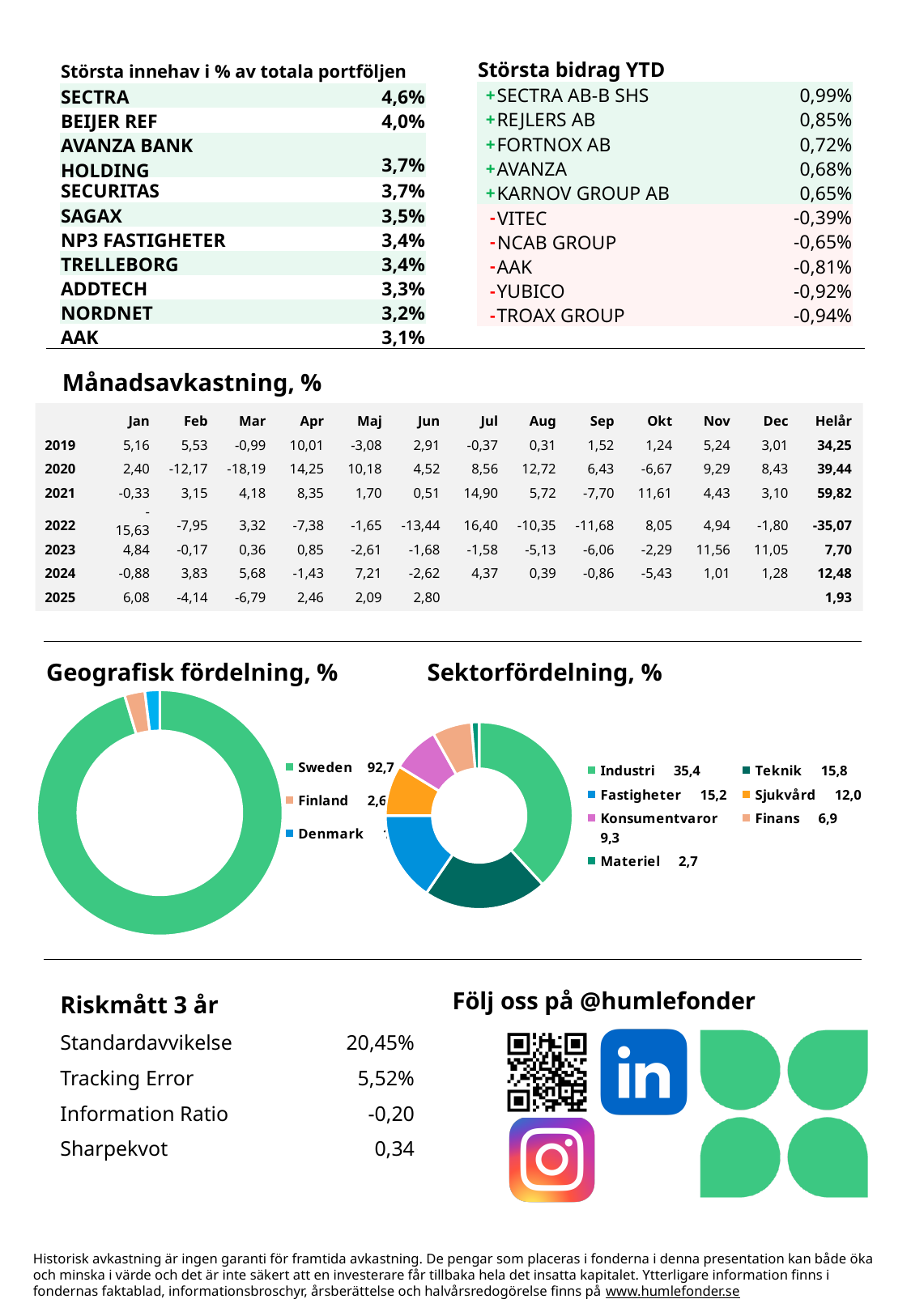
In the 'Geografisk fördelning, %' chart, what is the value for Sweden? 92,7 How many sectors are listed in the legend of the 'Sektorfördelning, %' chart? 7 In the 'Sektorfördelning, %' chart, which sector has the largest share? Industri In the 'Geografisk fördelning, %' chart, what is the value for Finland? 2,6 In the 'Geografisk fördelning, %' chart, which country has the largest share? Sweden How many countries are listed in the legend of the 'Geografisk fördelning, %' chart? 3 In the 'Sektorfördelning, %' chart, which is larger, Konsumentvaror or Finans? Konsumentvaror In the 'Sektorfördelning, %' chart, what is the difference between Industri and Teknik? 19,6 In the 'Sektorfördelning, %' chart, what is the value for Industri? 35,4 In the 'Sektorfördelning, %' chart, what is the value for Sjukvård? 12,0 What kind of chart is 'Geografisk fördelning, %'? Donut (pie) chart In the 'Sektorfördelning, %' chart, which sector has the smallest share? Materiel